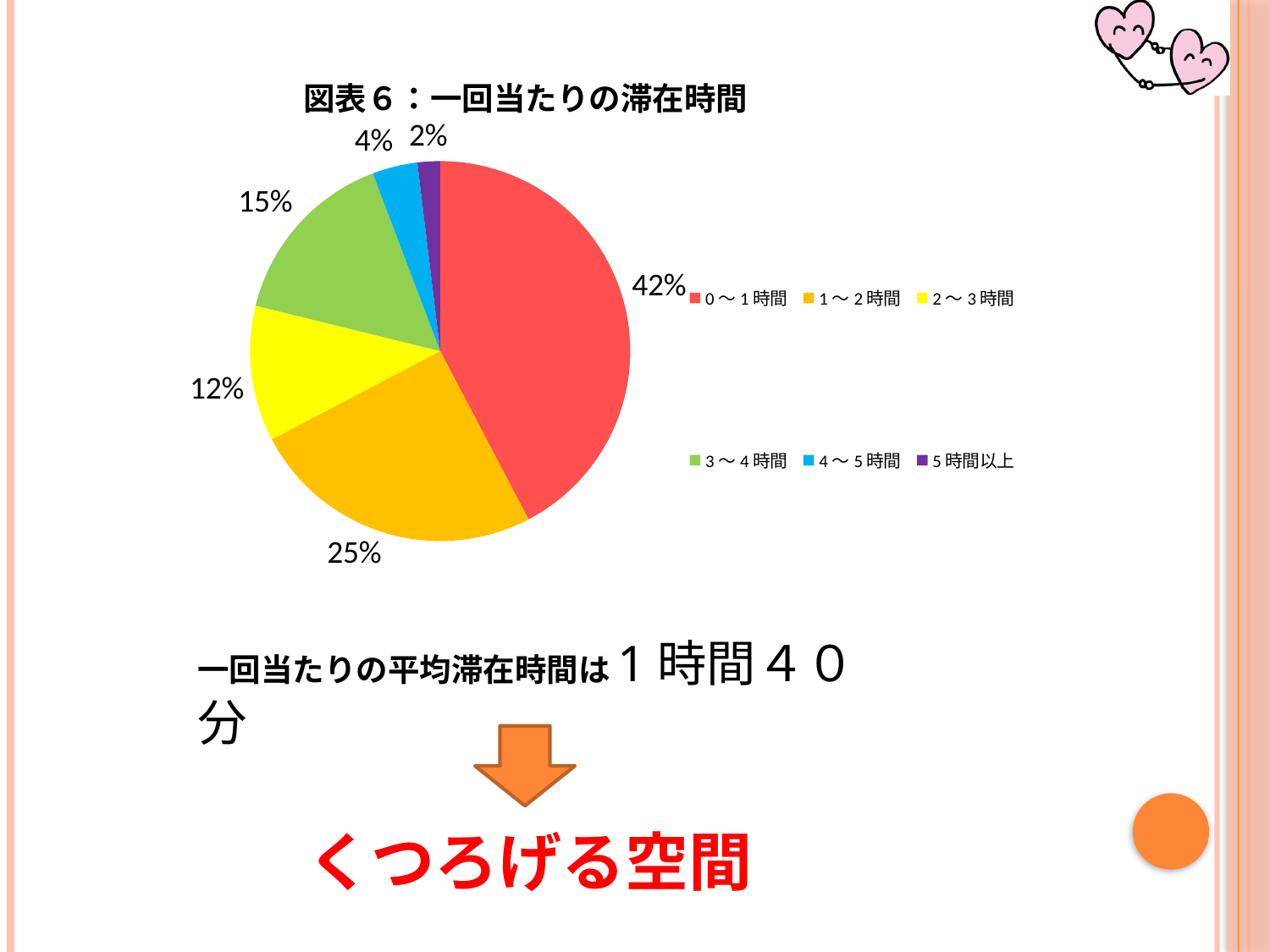
Which category has the largest slice? 0～1時間 What is the value for 5時間以上? 2% What is the value for 2～3時間? 12% What is the difference between the 0～1時間 and 1～2時間 slices? 17% What share of the pie does the 0～1時間 slice represent? 42% What is the value for 3～4時間? 15% What kind of chart is shown on the slide? pie chart How many categories does the legend list? 6 Which category has the smallest slice? 5時間以上 What is the value for 4～5時間? 4% What is the title of the chart? 図表６：一回当たりの滞在時間 What share of the pie does the 1～2時間 slice represent? 25%